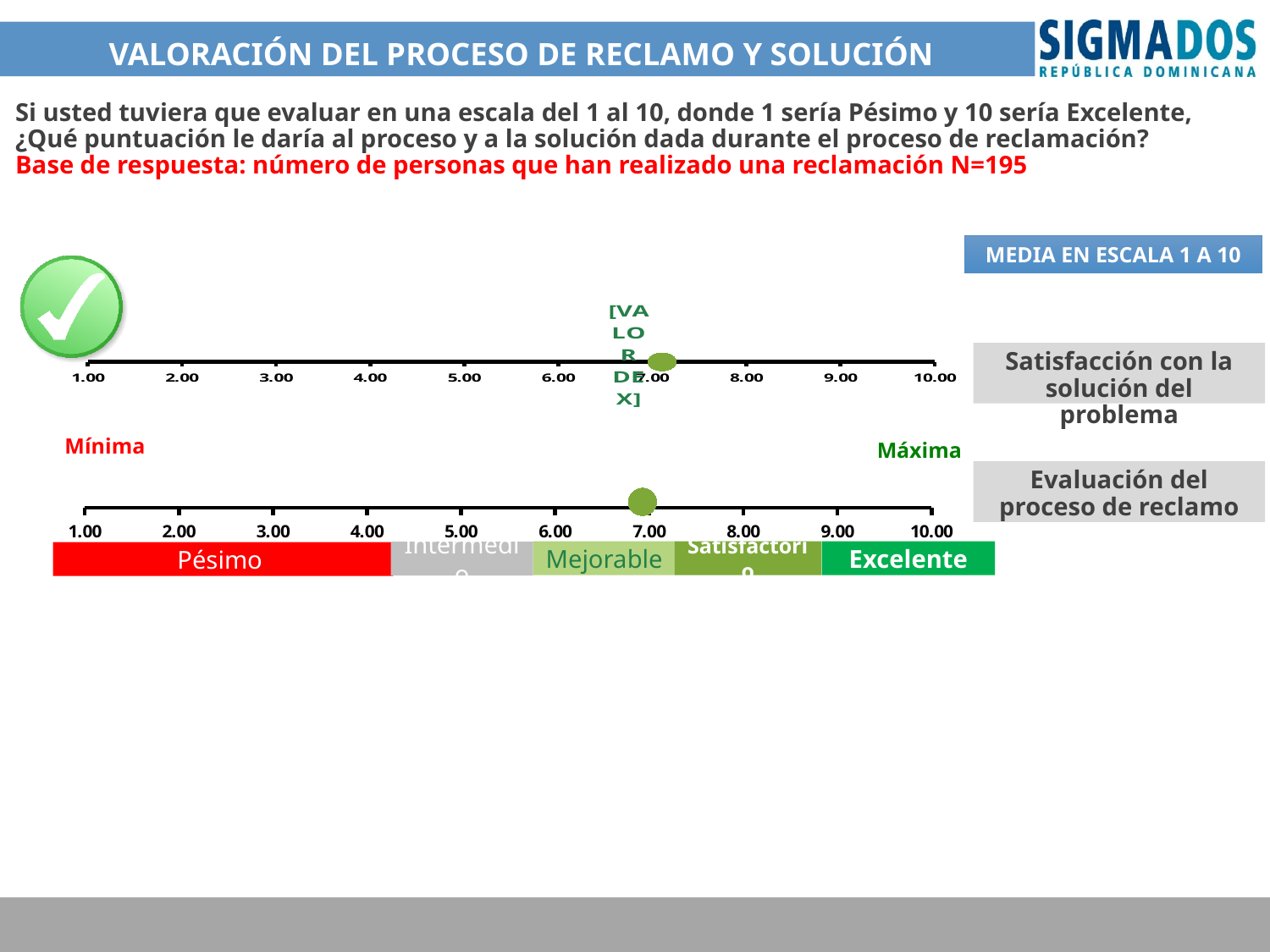
How many axis tick labels are shown on the 'Evaluación del proceso de reclamo' chart? 10 On the 'Evaluación del proceso de reclamo' chart, is the plotted value greater or less than 8.00? less On the 'Satisfacción con la solución del problema' chart, is the plotted value greater or less than 9.00? less What is the lowest tick value shown on the axis of the 'Satisfacción con la solución del problema' chart? 1.00 What is the highest tick value shown on the axis of the 'Evaluación del proceso de reclamo' chart? 10.00 How many data points are plotted on the 'Satisfacción con la solución del problema' chart? 1 On the 'Evaluación del proceso de reclamo' chart, is the plotted value greater or less than 6.00? greater